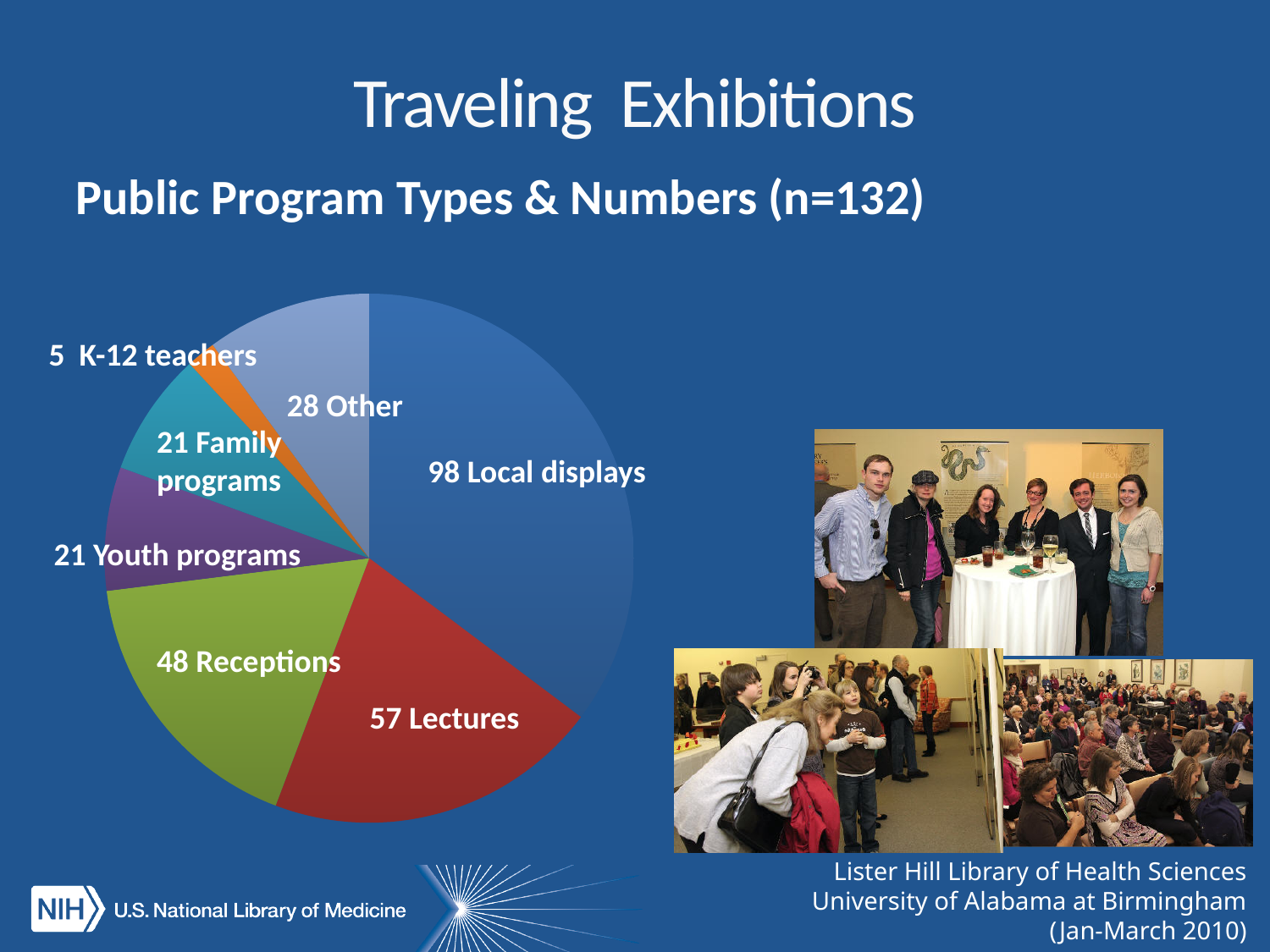
Which is larger, the number of Lectures or the number of Receptions? Lectures Which program type has the largest slice of the pie chart? Local displays What is the value for K-12 teachers in the pie chart? 5 What kind of chart is shown on the slide? pie chart How many Receptions are shown in the pie chart? 48 How many Lectures are shown in the pie chart? 57 Which program type has the smallest slice of the pie chart? K-12 teachers What is the title of the chart on the slide? Public Program Types & Numbers (n=132) What is the difference between the number of Local displays and the number of Lectures? 41 What is the value for Other in the pie chart? 28 What is the number of Local displays shown in the pie chart? 98 How many program types (slices) does the pie chart show? 7